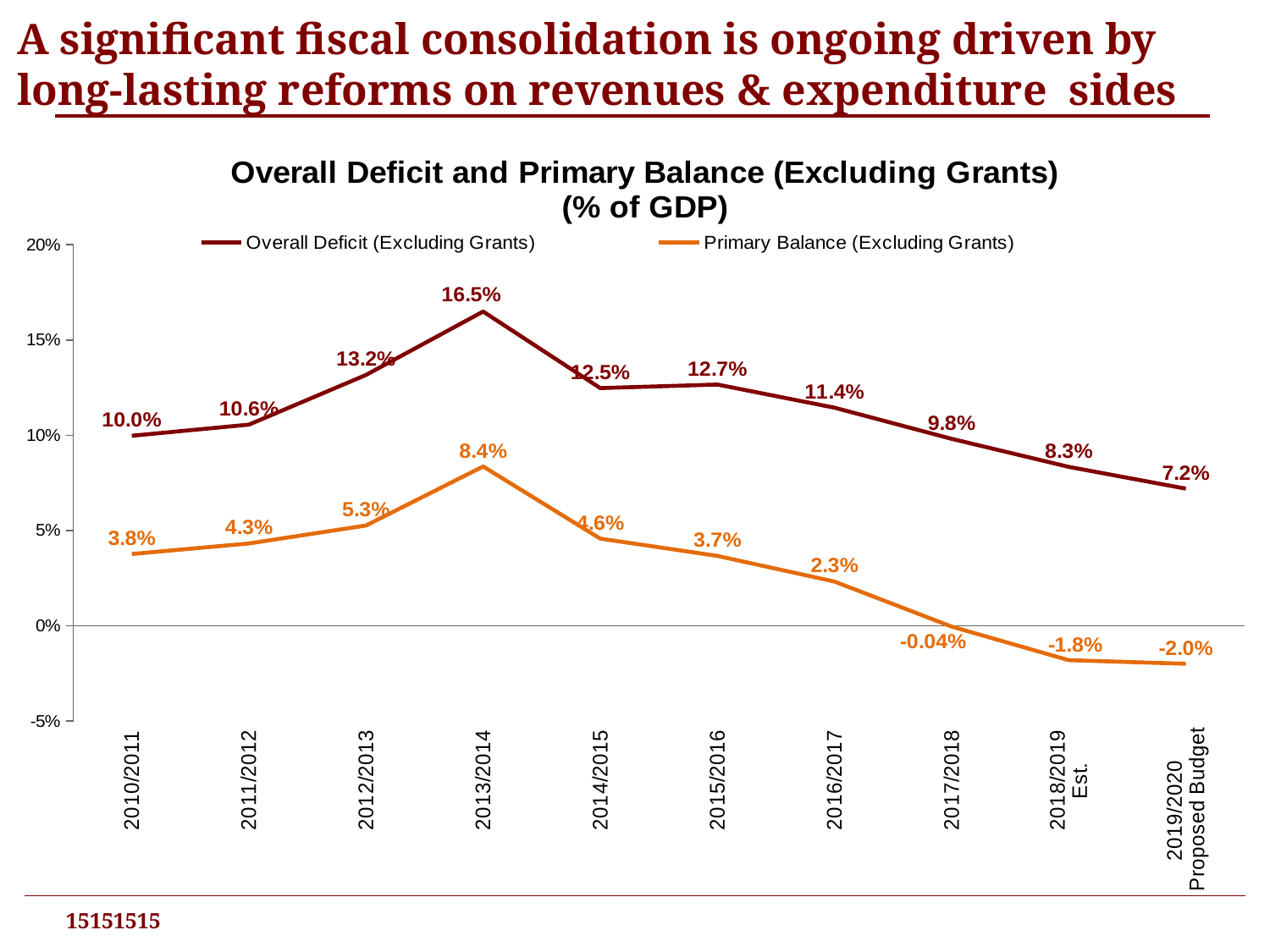
What is the Overall Deficit (Excluding Grants) value for 2019/2020 Proposed Budget? 7.2% How many series does the legend list? 2 What is the Primary Balance (Excluding Grants) value for 2017/2018? -0.04% In which year is the Primary Balance (Excluding Grants) lowest? 2019/2020 Proposed Budget What is the difference between the Overall Deficit (Excluding Grants) and the Primary Balance (Excluding Grants) in 2010/2011? 6.2% In which year is the Overall Deficit (Excluding Grants) highest? 2013/2014 What is the Overall Deficit (Excluding Grants) value for 2013/2014? 16.5% Which is larger: the Overall Deficit (Excluding Grants) in 2015/2016 or in 2016/2017? 2015/2016 Does the Overall Deficit (Excluding Grants) rise or fall from 2013/2014 to 2019/2020 Proposed Budget? Fall What is the title of the chart? Overall Deficit and Primary Balance (Excluding Grants) (% of GDP) What kind of chart is shown on the slide? Line chart How many years are shown on the x axis? 10